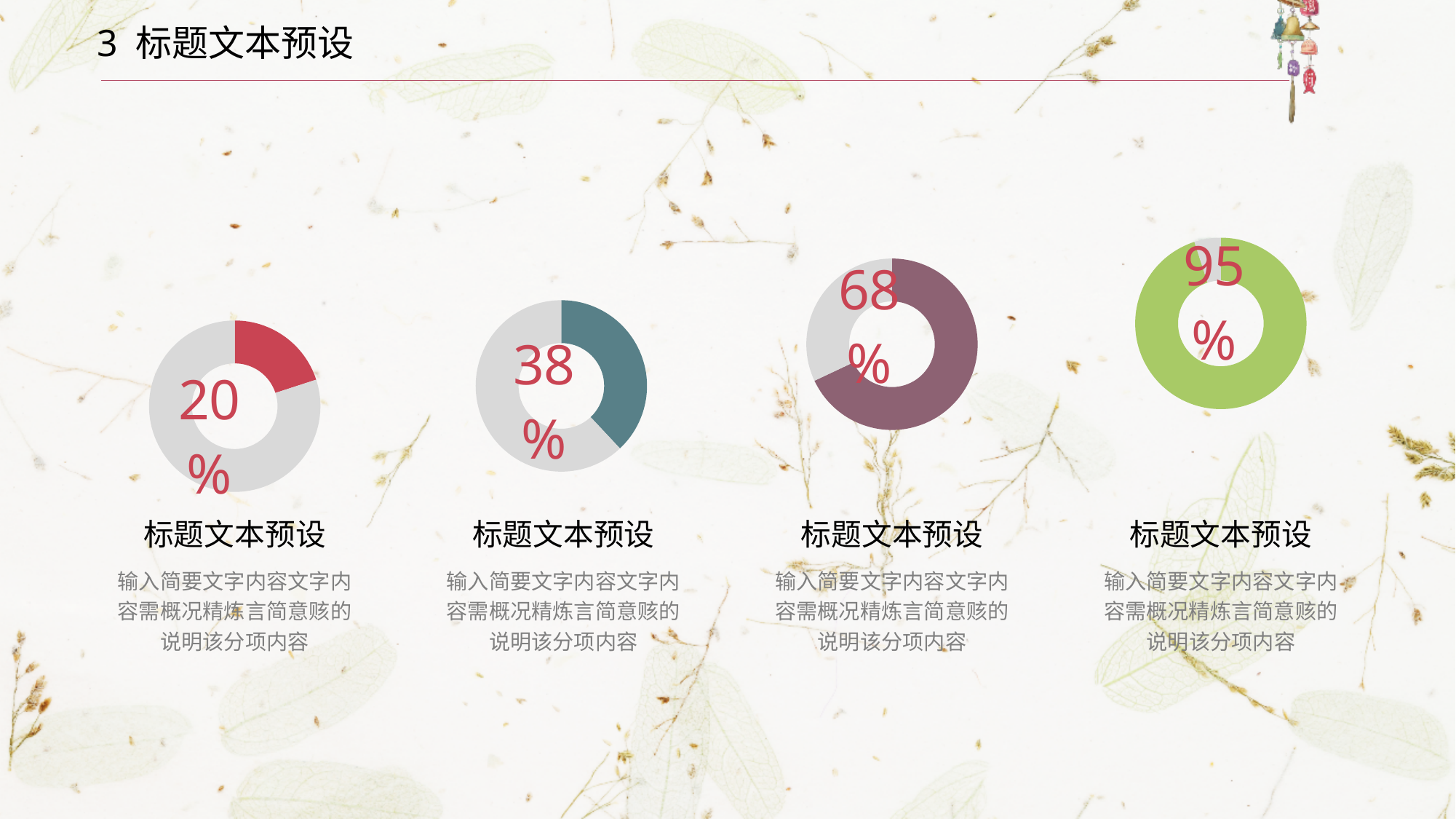
What percentage is shown in the third donut chart from the left? 68% Which donut chart shows the lowest percentage? The leftmost one (20%) What percentage is shown in the rightmost donut chart? 95% How many donut charts are on the slide? 4 What is the difference between the percentage in the rightmost donut chart and the percentage in the leftmost donut chart? 75% Which donut chart shows the highest percentage? The rightmost one (95%) What colour is the filled portion of the rightmost donut chart? Green What percentage is shown in the second donut chart from the left? 38% Which is larger, the percentage in the second donut chart from the left or the percentage in the third donut chart from the left? The third donut chart (68%) What kind of chart is used for each of the four figures on the slide? Donut chart What percentage is shown in the leftmost donut chart? 20% What is the difference between the percentages in the third and second donut charts from the left? 30%